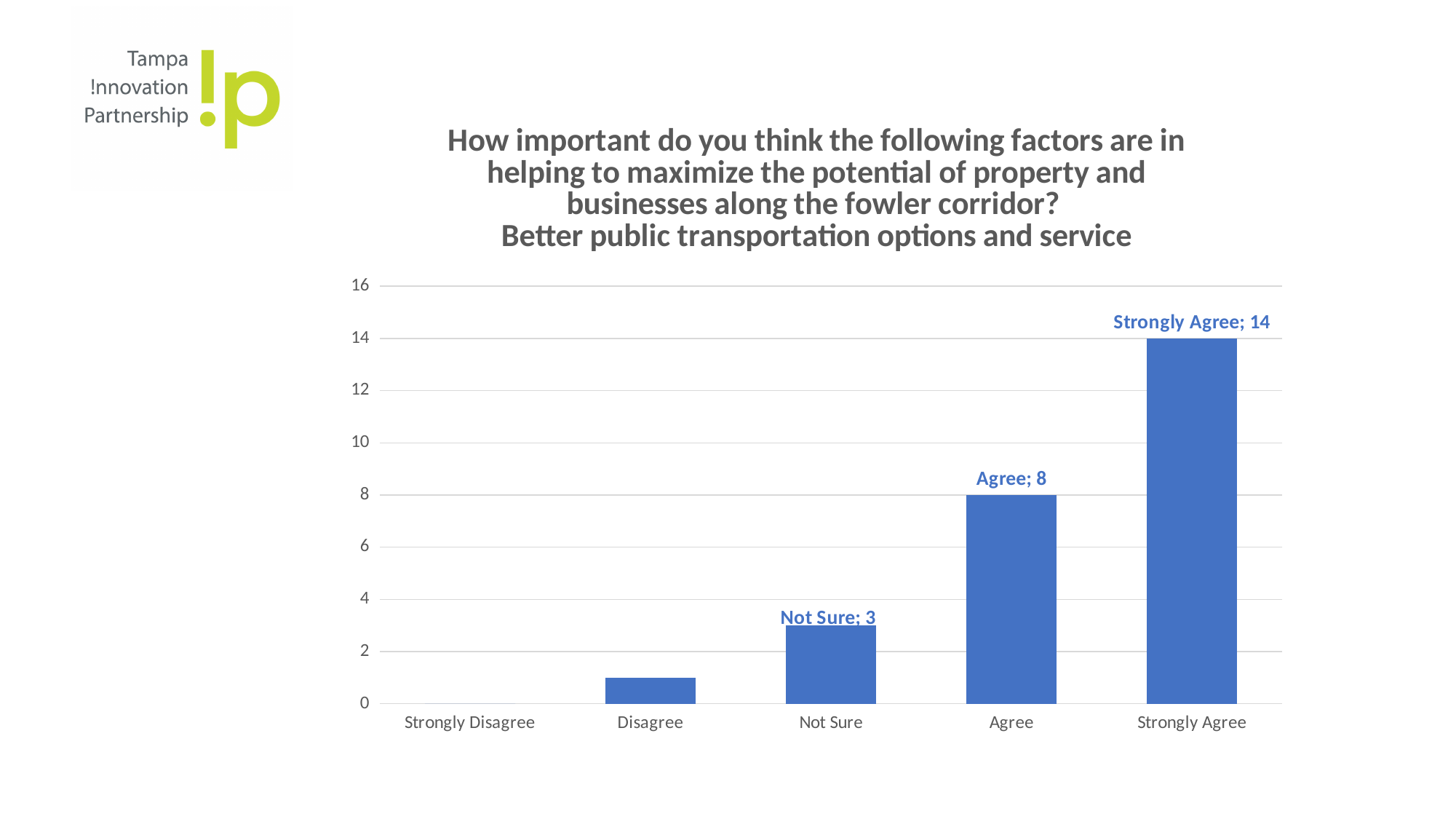
What kind of chart is shown on the slide? bar chart Do the values rise or fall from Strongly Disagree to Strongly Agree along the x axis? rise How many categories are shown on the x axis? 5 What is the value for Not Sure? 3 Which category has the lowest value? Strongly Disagree Which category has the highest value? Strongly Agree Is the value for Disagree greater or less than 2? less Which is larger, the value for Disagree or the value for Not Sure? Not Sure What is the difference between the values for Strongly Agree and Agree? 6 What is the difference between the values for Agree and Not Sure? 5 What is the value for Strongly Agree? 14 What is the value for Agree? 8